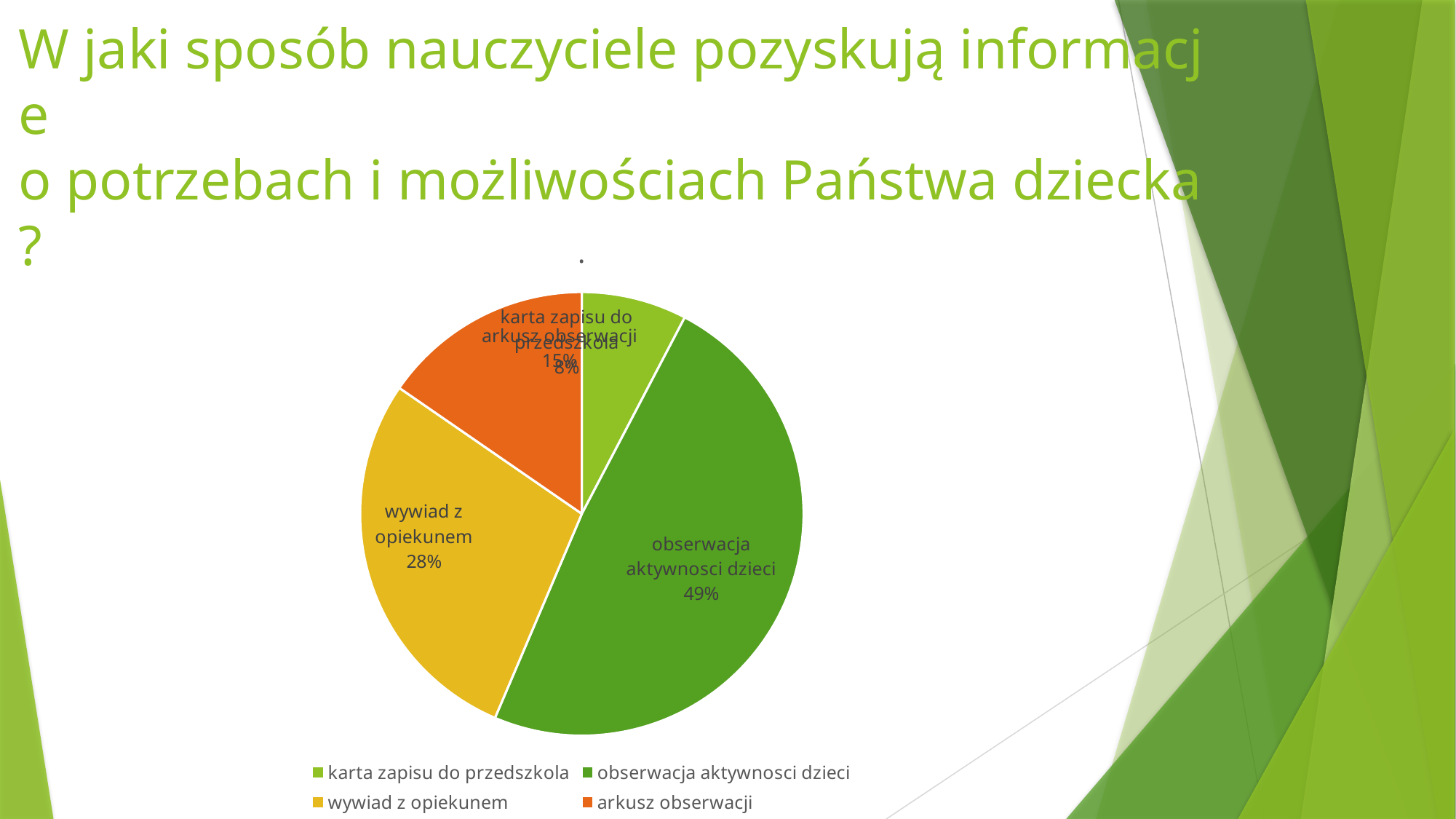
How many entries does the chart legend list? 4 What percentage of the pie chart is 'obserwacja aktywnosci dzieci'? 49% Which category has the smallest share of the pie chart? karta zapisu do przedszkola How many slices does the pie chart have? 4 Which category has the largest share of the pie chart? obserwacja aktywnosci dzieci What is the difference in percentage points between 'obserwacja aktywnosci dzieci' and 'wywiad z opiekunem'? 21 What percentage of the pie chart is 'arkusz obserwacji'? 15% What percentage of the pie chart is 'wywiad z opiekunem'? 28% What percentage of the pie chart is 'karta zapisu do przedszkola'? 8% What type of chart is shown on the slide? pie chart Which is larger: the share for 'arkusz obserwacji' or for 'wywiad z opiekunem'? wywiad z opiekunem What colour is the slice for 'wywiad z opiekunem'? yellow